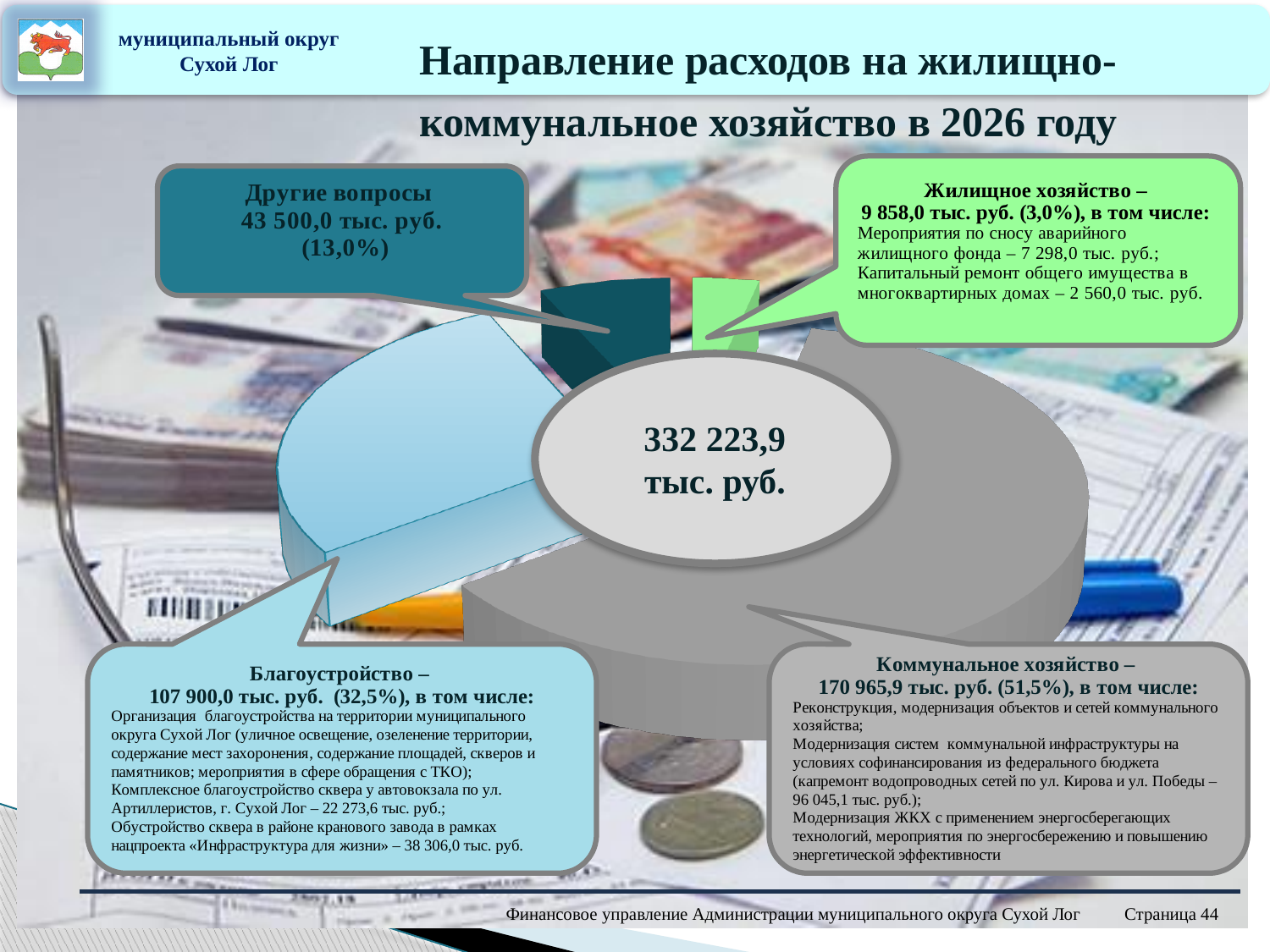
Which category has the largest share of the pie? Коммунальное хозяйство What is the value for Коммунальное хозяйство? 170 965,9 тыс. руб. What kind of chart is shown on the slide? pie chart What is the value for Жилищное хозяйство? 9 858,0 тыс. руб. What total value is shown in the centre of the pie chart? 332 223,9 тыс. руб. What share of the pie does Благоустройство represent? 32,5% What is the value for Другие вопросы? 43 500,0 тыс. руб. What share of the pie does Другие вопросы represent? 13,0% What is the value for Благоустройство? 107 900,0 тыс. руб. How many slices does the pie chart have? 4 Which is larger, Благоустройство or Другие вопросы? Благоустройство Which category has the smallest share of the pie? Жилищное хозяйство